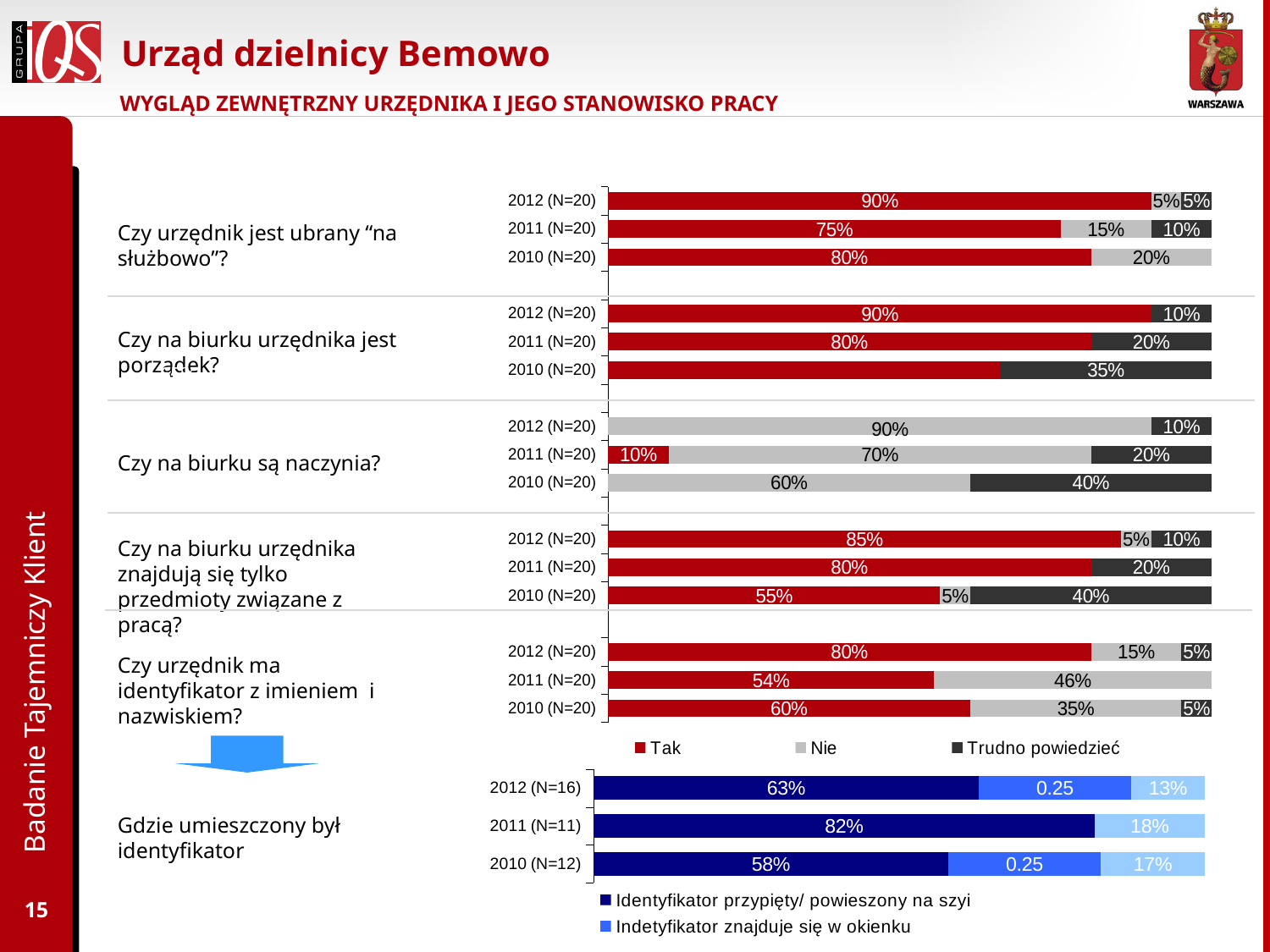
How many series does the legend of the upper chart (Tak / Nie / Trudno powiedzieć) list? 3 In the upper chart, for "Czy na biurku są naczynia?", what is the "Tak" value for 2011 (N=20)? 10% What kind of chart is used on this slide? Stacked bar chart In the lower chart "Gdzie umieszczony był identyfikator", which year has the highest value for "Identyfikator przypięty/ powieszony na szyi"? 2011 (N=11) In the upper chart, for "Czy urzędnik ma identyfikator z imieniem i nazwiskiem?", what is the "Nie" value for 2011 (N=20)? 46% In the lower chart "Gdzie umieszczony był identyfikator", what is the value of "Identyfikator przypięty/ powieszony na szyi" for 2011 (N=11)? 82% In the upper chart, for "Czy na biurku są naczynia?", does the "Nie" value rise or fall from 2010 to 2012? Rises In the lower chart "Gdzie umieszczony był identyfikator", what value is printed for "Indetyfikator znajduje się w okienku" for 2010 (N=12)? 0.25 In the upper chart, for "Czy urzędnik jest ubrany "na służbowo"?", what is the "Tak" value for 2012 (N=20)? 90% In the upper chart, for "Czy urzędnik ma identyfikator z imieniem i nazwiskiem?", what is the difference between the "Tak" values for 2012 and 2011? 26 percentage points In the upper chart, for "Czy na biurku urzędnika jest porządek?", which year has the larger "Tak" value, 2012 or 2011? 2012 How many years (bars) are shown for each question in the upper chart? 3